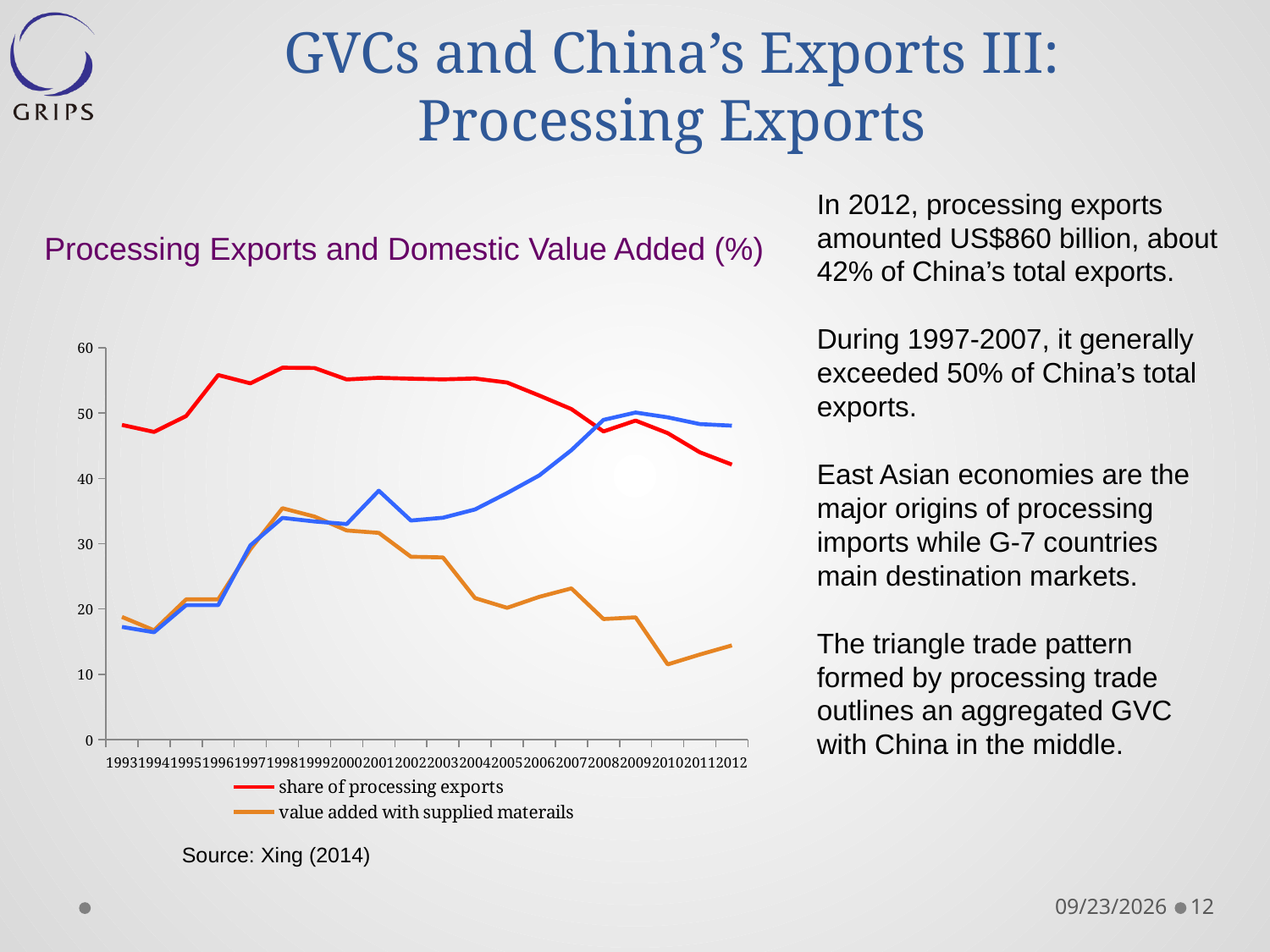
What kind of chart is shown on the slide? line chart Is the value for share of processing exports in 1998 greater or less than 50? greater Does the share of processing exports rise or fall from 2007 to 2012? fall In which year is value added with supplied materails lowest? 2010 How many years are shown on the x axis of the chart? 20 Is the value for share of processing exports in 2012 greater or less than 50? less How many series does the chart's legend list? 2 Is the value for value added with supplied materails in 1998 greater or less than 30? greater What is the title of the chart? Processing Exports and Domestic Value Added (%) In which year is the share of processing exports lowest? 2012 In 2012, which is larger: share of processing exports or value added with supplied materails? share of processing exports